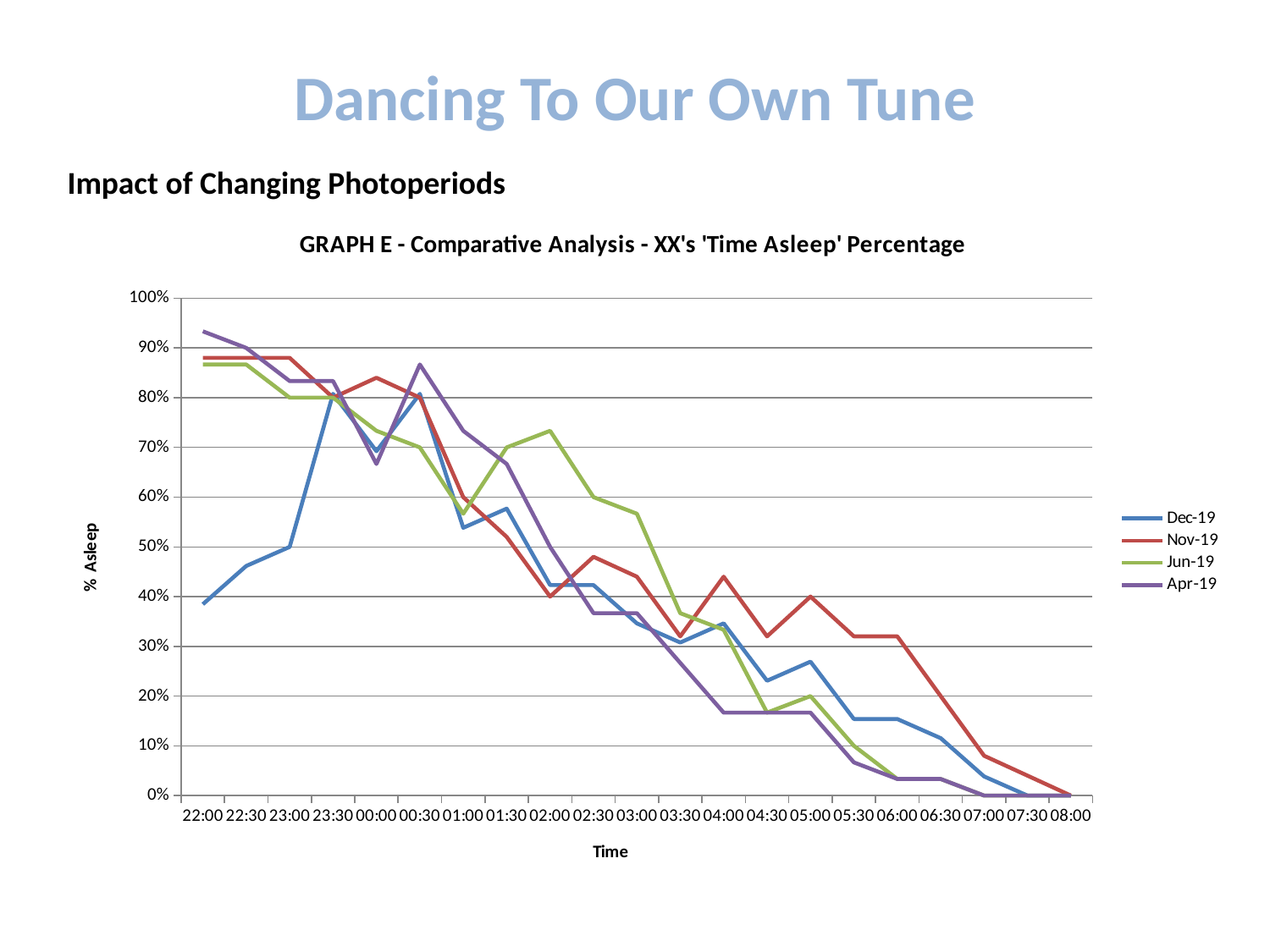
At 02:00, which is larger: the Jun-19 value or the Nov-19 value? Jun-19 At 04:00, which is larger: the Nov-19 value or the Apr-19 value? Nov-19 What kind of chart is GRAPH E? line chart Is the Nov-19 value at 06:00 greater or less than 20%? greater How many time points are shown along the x axis? 21 What is the label on the vertical axis? % Asleep Which series has the highest value at 05:00? Nov-19 Overall, do the '% Asleep' values rise or fall from 22:00 to 08:00? fall Is the Dec-19 value at 22:00 greater or less than 50%? less Which series has the lowest value at 22:00? Dec-19 Which series has the highest value at 22:00? Apr-19 How many series does the legend list? 4